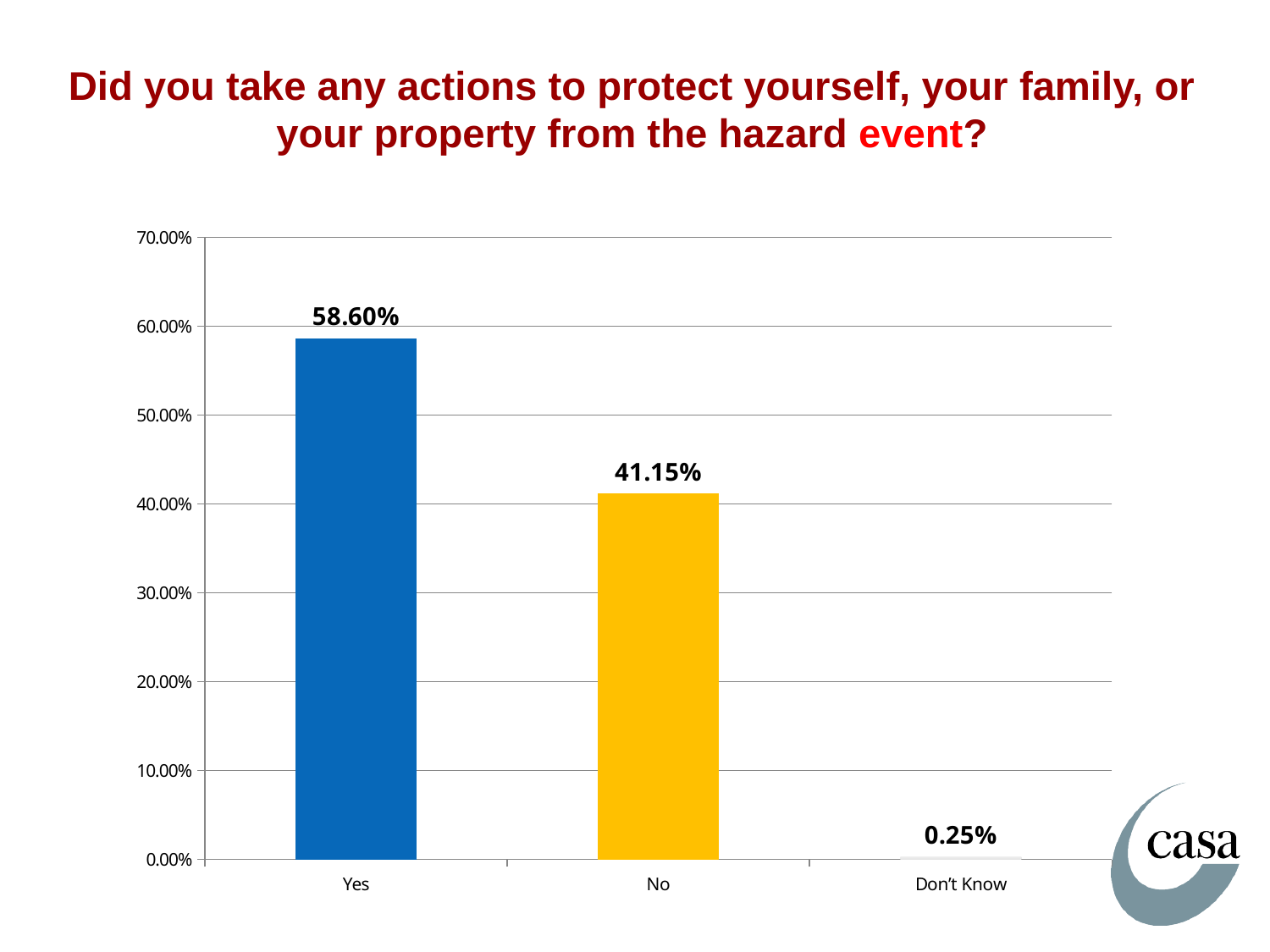
Which response category has the lowest value? Don't Know Do the values rise or fall from left to right across the categories? Fall Which is larger, the value for Yes or the value for No? Yes How many response categories are shown on the x axis? 3 What kind of chart is shown on the slide? Bar chart Which response category has the highest value? Yes What is the difference between the Yes and No percentages? 17.45% What percentage of respondents answered Don't Know? 0.25% What colour is the bar for the No category? Yellow What percentage of respondents answered No? 41.15% What percentage of respondents answered Yes? 58.60% Is the value for No greater or less than 50.00%? less